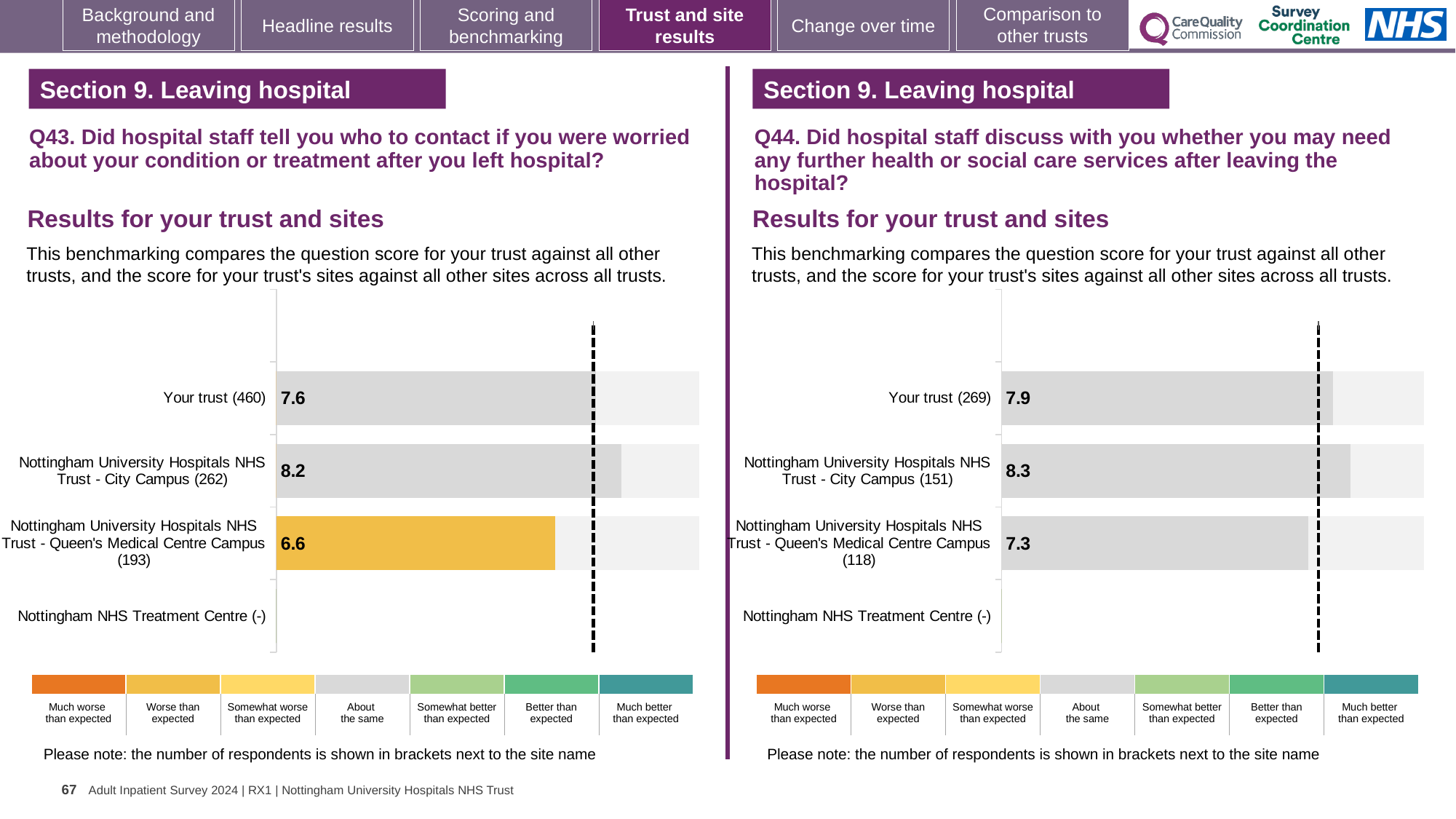
Which is larger: the Your trust score in the Q43 chart on the left or the Your trust score in the Q44 chart on the right? Q44 (7.9) In the Q43 chart on the left, which bar is coloured orange-yellow rather than grey? Nottingham University Hospitals NHS Trust - Queen's Medical Centre Campus (193) In the Q43 chart on the left, what is the score for Nottingham University Hospitals NHS Trust - Queen's Medical Centre Campus (193)? 6.6 In the Q44 chart on the right, what is the difference between the City Campus score and the Your trust score? 0.4 In the Q43 chart on the left, what is the difference between the City Campus score and the Queen's Medical Centre Campus score? 1.6 In the Q44 chart on the right, what is the score for Nottingham University Hospitals NHS Trust - City Campus (151)? 8.3 In the Q43 chart on the left, which site or trust has the highest score? Nottingham University Hospitals NHS Trust - City Campus (262) In the Q43 chart on the left, how many sites or trusts have a score shown as a bar? 3 What type of chart is used in the Q44 chart on the right? Bar chart In the Q44 chart on the right, which site or trust has the lowest score? Nottingham University Hospitals NHS Trust - Queen's Medical Centre Campus (118) In the Q43 chart on the left, what is the score for Your trust (460)? 7.6 In the Q44 chart on the right, what is the score for Your trust (269)? 7.9